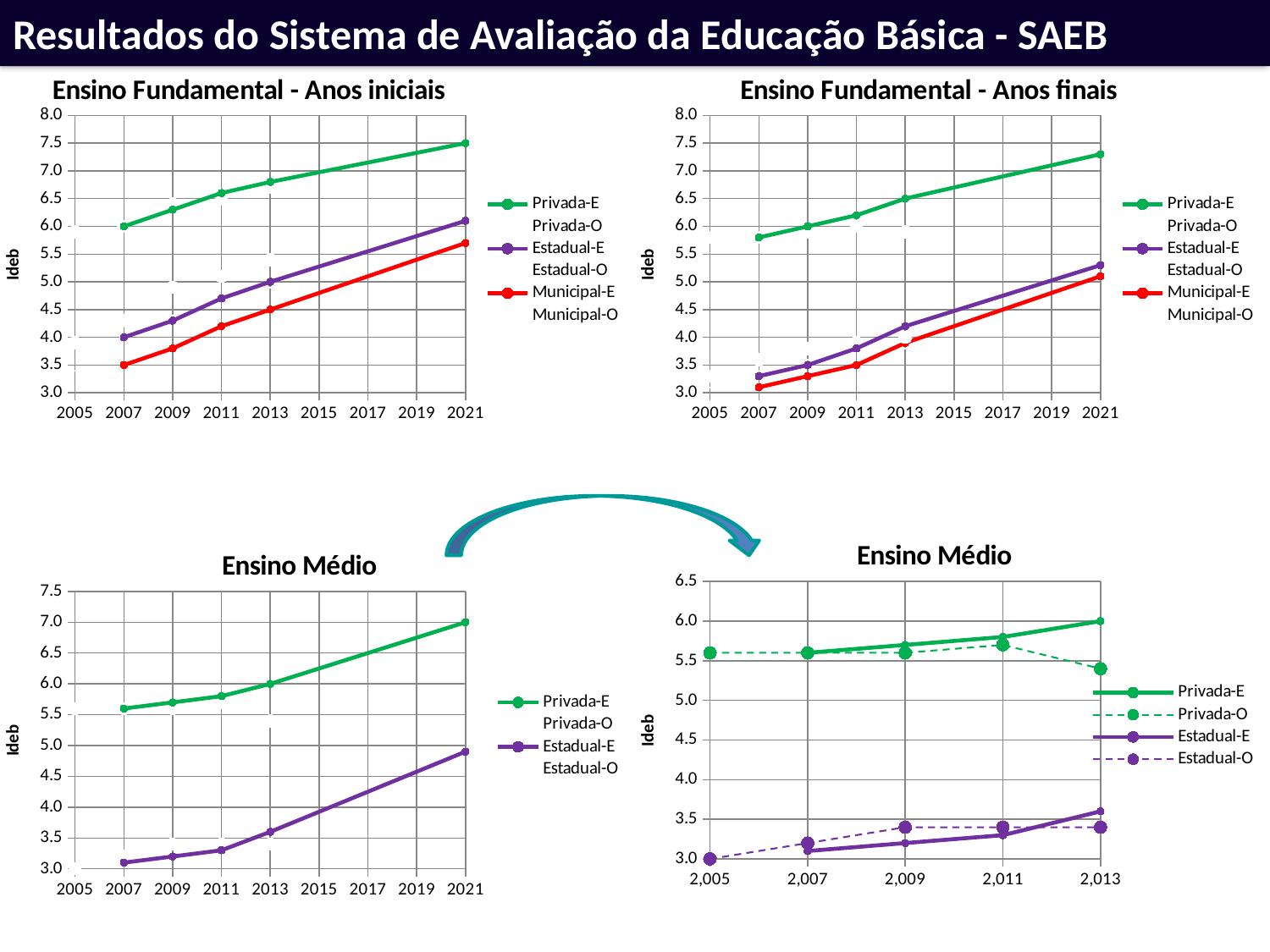
In the 'Ensino Fundamental - Anos iniciais' chart, what is the Ideb value for Privada-E in 2021? 7.5 In the 'Ensino Fundamental - Anos finais' chart, what is the Ideb value for Privada-E in 2013? 6.5 In the 'Ensino Fundamental - Anos iniciais' chart, what is the Ideb value for Municipal-E in 2007? 3.5 In the 'Ensino Fundamental - Anos iniciais' chart, which series has the highest Ideb in 2021? Privada-E In the 'Ensino Médio' chart on the bottom right, which is larger in 2013: Privada-E or Privada-O? Privada-E How many series does the legend of the 'Ensino Fundamental - Anos iniciais' chart list? 6 In the 'Ensino Fundamental - Anos finais' chart, is the Ideb value for Privada-E in 2021 greater or less than 7.0? greater In the 'Ensino Fundamental - Anos finais' chart, is the Ideb value for Municipal-E in 2007 greater or less than 3.5? less In the 'Ensino Médio' chart on the bottom left, does the Estadual-E series rise or fall from 2007 to 2021? rise In the 'Ensino Médio' chart on the bottom left, what is the Ideb value for Privada-E in 2021? 7.0 What kind of chart is the 'Ensino Médio' chart on the bottom right? line chart In the 'Ensino Fundamental - Anos iniciais' chart, which series has the lowest Ideb in 2007? Municipal-E